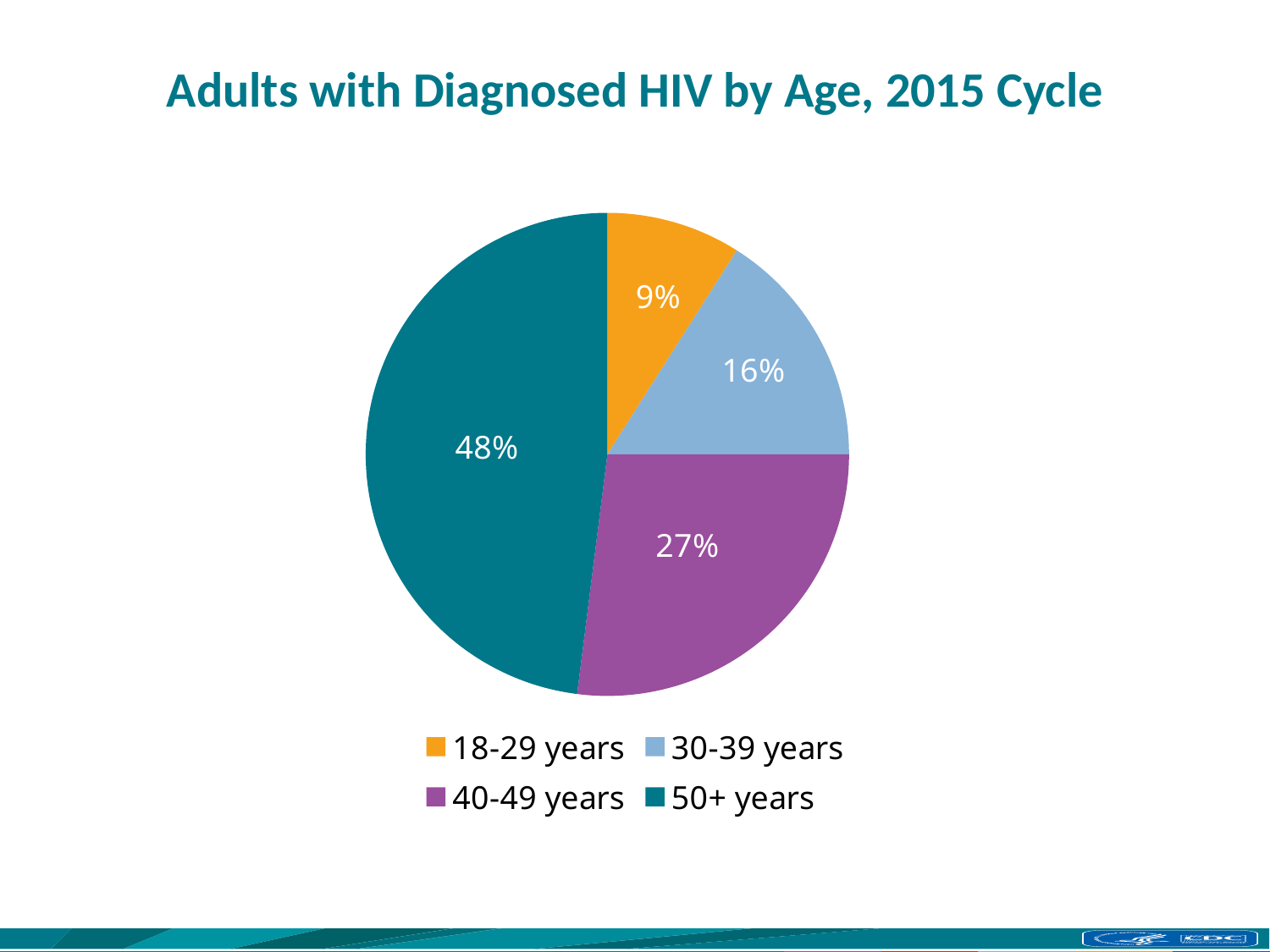
Which age group has the largest share of adults with diagnosed HIV? 50+ years What type of chart is shown on the slide? Pie chart What percentage of adults with diagnosed HIV are aged 40-49 years? 27% What is the difference in percentage points between the 50+ years and 40-49 years groups? 21 How many age groups are shown in the pie chart? 4 What percentage of adults with diagnosed HIV are aged 30-39 years? 16% What is the title of the chart? Adults with Diagnosed HIV by Age, 2015 Cycle What percentage of adults with diagnosed HIV are aged 18-29 years? 9% What percentage of adults with diagnosed HIV are aged 50+ years? 48% What colour represents the 40-49 years group in the pie chart? Purple Which age group has the smallest share of adults with diagnosed HIV? 18-29 years Which group has a larger share: 30-39 years or 40-49 years? 40-49 years